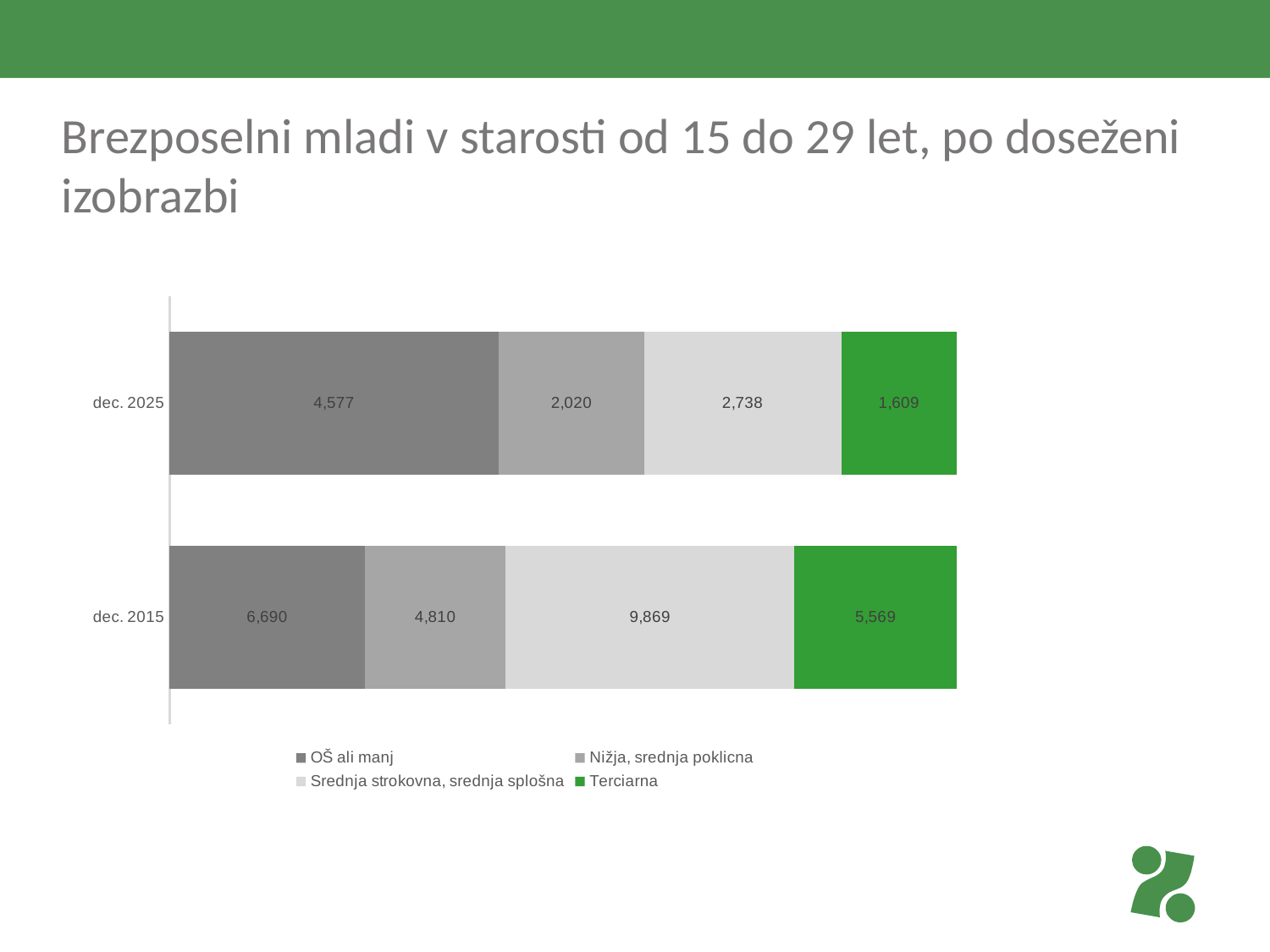
What is the value for "OŠ ali manj" in dec. 2025? 4,577 What kind of chart is shown on the slide? Stacked bar chart What is the total of the stacked bar for dec. 2015? 26,938 What is the value for "Nižja, srednja poklicna" in dec. 2015? 4,810 What is the value for "Srednja strokovna, srednja splošna" in dec. 2025? 2,738 What is the difference between the "OŠ ali manj" values in dec. 2015 and dec. 2025? 2,113 Which education group has the lowest value in dec. 2025? Terciarna Which is larger: "Nižja, srednja poklicna" in dec. 2025 or "Srednja strokovna, srednja splošna" in dec. 2025? Srednja strokovna, srednja splošna What is the value for "Terciarna" in dec. 2015? 5,569 Which education group has the highest value in dec. 2015? Srednja strokovna, srednja splošna How many series does the legend list? 4 What is the total of the stacked bar for dec. 2025? 10,944